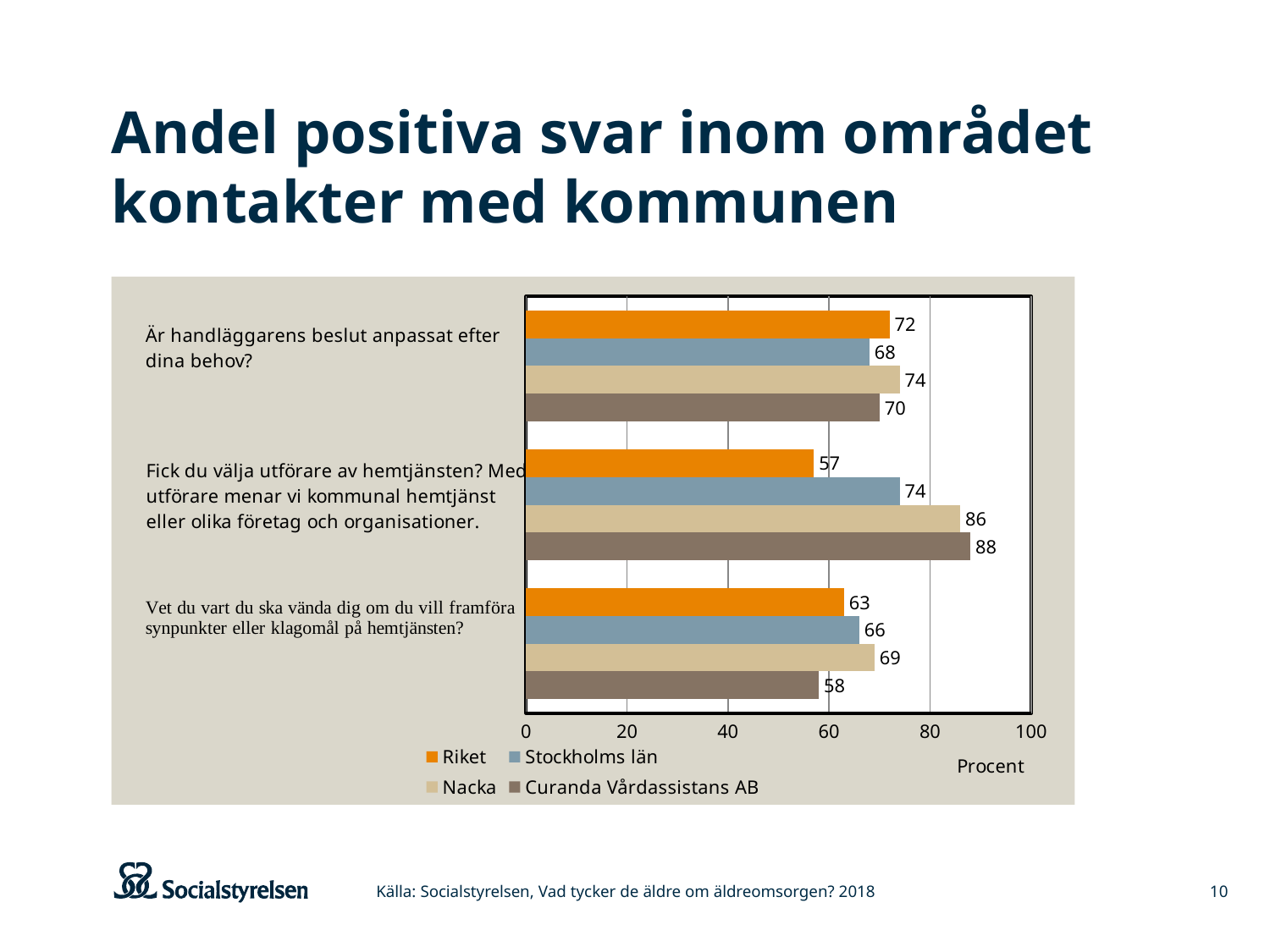
What is the difference between Nacka and Riket on the question "Fick du välja utförare av hemtjänsten?"? 29 How many series does the legend list? 4 What unit is shown on the horizontal axis of the chart? Procent Which series has the highest value on the question "Fick du välja utförare av hemtjänsten?"? Curanda Vårdassistans AB How many questions (categories) are shown on the chart? 3 Which is larger on the question "Är handläggarens beslut anpassat efter dina behov?": Stockholms län or Nacka? Nacka Which series has the lowest value on the question "Vet du vart du ska vända dig om du vill framföra synpunkter eller klagomål på hemtjänsten?"? Curanda Vårdassistans AB What is the value for Nacka on the question "Vet du vart du ska vända dig om du vill framföra synpunkter eller klagomål på hemtjänsten?"? 69 What is the value for Riket on the question "Är handläggarens beslut anpassat efter dina behov?"? 72 Is the value for Riket on the question "Fick du välja utförare av hemtjänsten?" greater or less than 60? less What is the value for Curanda Vårdassistans AB on the question "Fick du välja utförare av hemtjänsten?"? 88 What kind of chart is shown on the slide? Bar chart